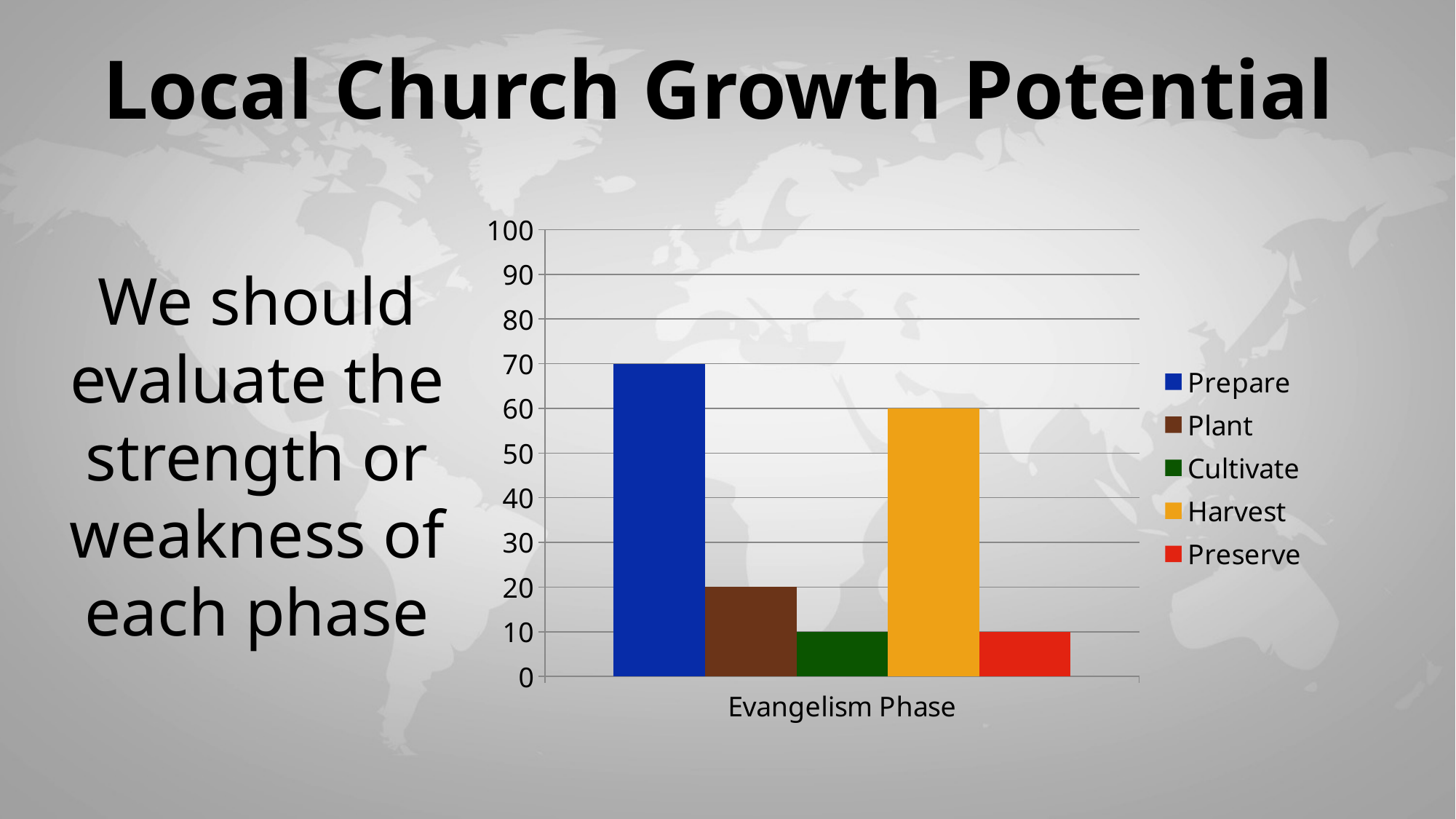
How many series does the legend list? 5 Which is larger, the value for Plant or the value for Harvest? Harvest What is the difference between the values for Plant and Cultivate? 10 What colour is the Harvest bar? yellow Which series has the highest value? Prepare What is the label on the x axis of the chart? Evangelism Phase What is the value for Harvest? 60 What kind of chart is shown on the slide? bar chart What is the difference between the values for Prepare and Harvest? 10 Is the value for Prepare greater or less than 50? greater What is the value for Prepare? 70 What is the value for Plant? 20